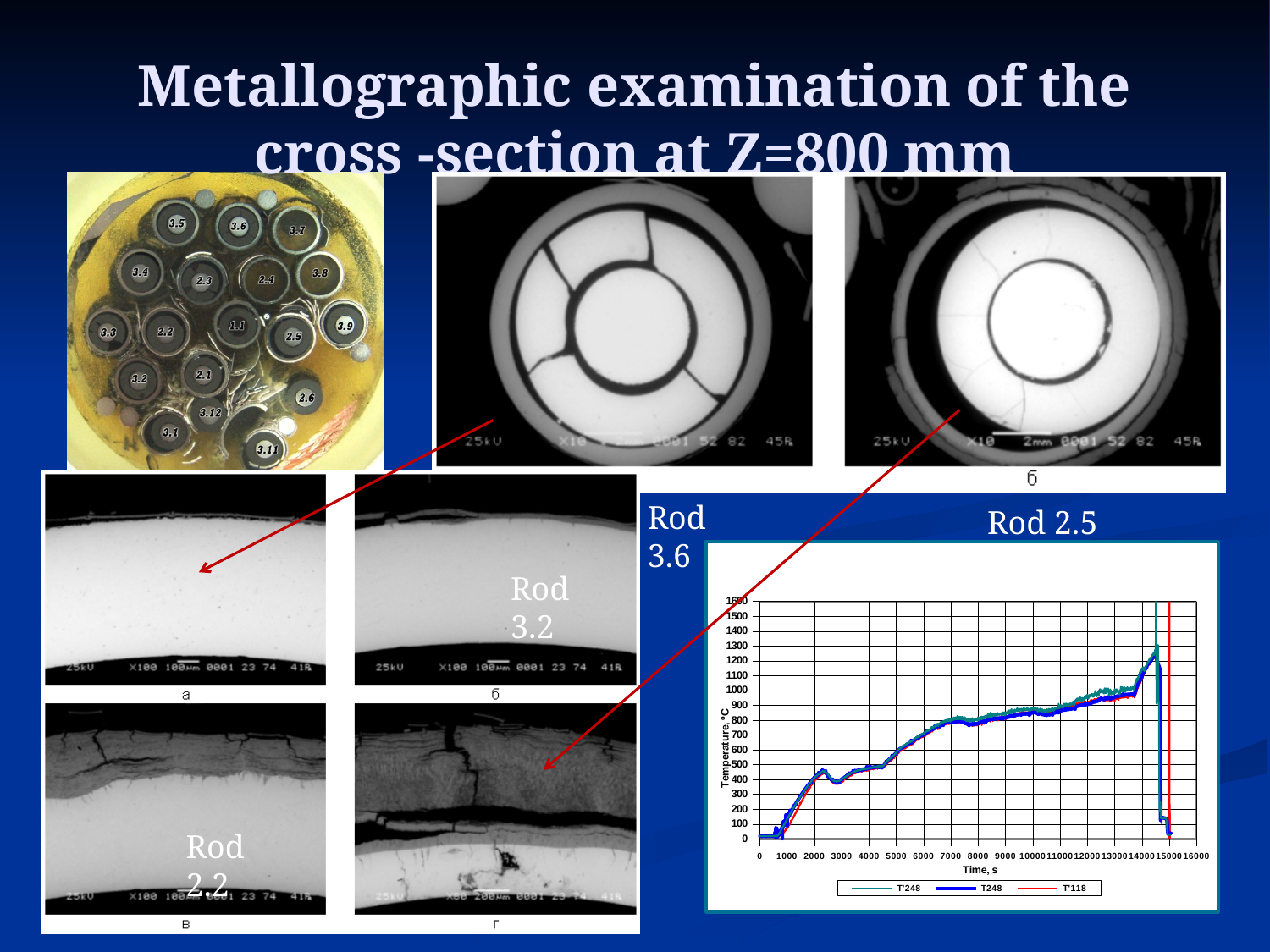
How many series does the legend of the Rod 2.5 chart list? 3 What kind of chart is shown for Rod 2.5? line chart In the Rod 2.5 chart, is the temperature at 2000 s greater or less than 800? less In the Rod 2.5 chart, is the temperature at 10000 s greater or less than 500? greater In the Rod 2.5 chart, is the temperature at 7000 s greater or less than 1000? less What are the legend entries of the Rod 2.5 chart? T'248, T248, T'118 In the Rod 2.5 chart, does the temperature generally rise or fall between 5000 s and 14000 s? rise What is the y-axis label of the Rod 2.5 chart? Temperature, °C